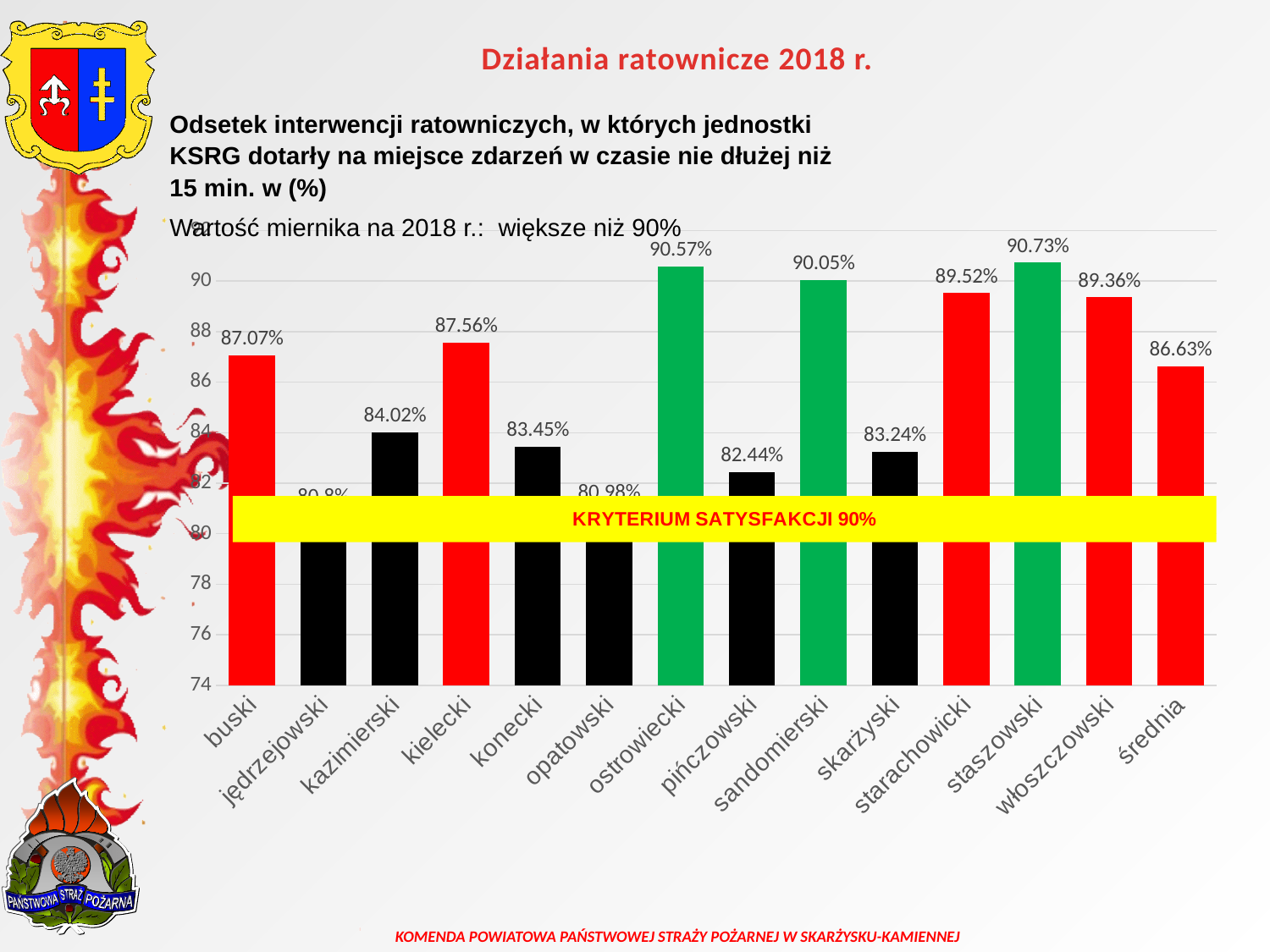
Which is larger, the value for kielecki or the value for buski? kielecki What is the difference between the values for ostrowiecki and sandomierski? 0.52 percentage points What is the value for staszowski? 90.73% How many categories are shown on the x axis? 14 What is the value for buski? 87.07% What is the value for średnia? 86.63% What text is written in the yellow band across the chart? KRYTERIUM SATYSFAKCJI 90% Is the value for jędrzejowski greater or less than 82? less What kind of chart is shown on the slide? bar chart Which category has the highest value? staszowski What is the difference between the values for staszowski and średnia? 4.1 percentage points How many bars are coloured green? 3